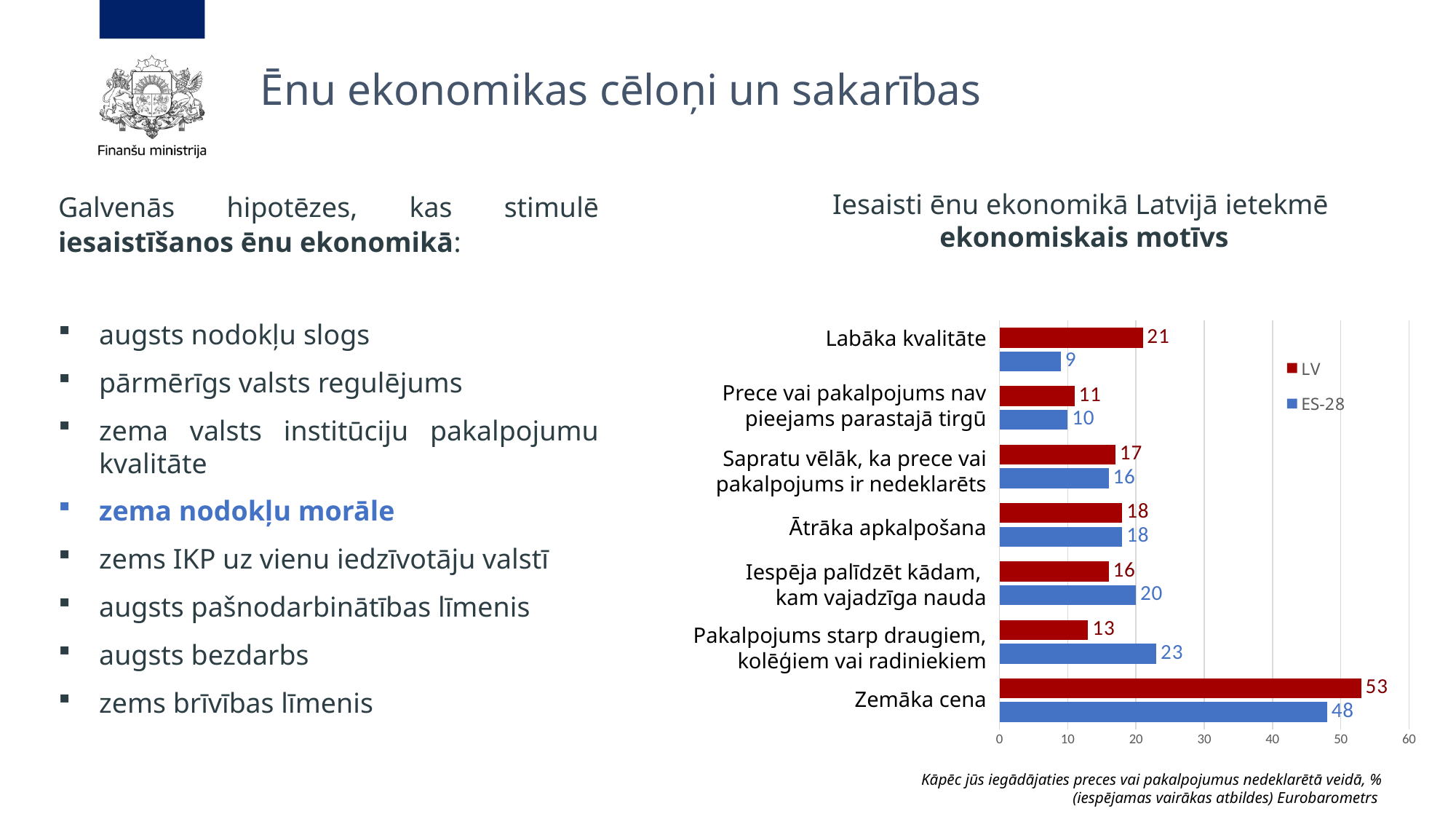
Which category has the highest LV value? Zemāka cena What is the LV value for "Zemāka cena"? 53 Which is larger for "Iespēja palīdzēt kādam, kam vajadzīga nauda": the LV value or the ES-28 value? ES-28 Which category has the lowest ES-28 value? Labāka kvalitāte Is the LV value for "Zemāka cena" greater or less than 50? greater What is the difference between the LV and ES-28 values for "Labāka kvalitāte"? 12 What is the difference between the ES-28 and LV values for "Pakalpojums starp draugiem, kolēģiem vai radiniekiem"? 10 What kind of chart is shown on the slide? bar chart How many categories are shown on the chart? 7 How many series does the legend list? 2 What is the ES-28 value for "Pakalpojums starp draugiem, kolēģiem vai radiniekiem"? 23 What is the ES-28 value for "Labāka kvalitāte"? 9